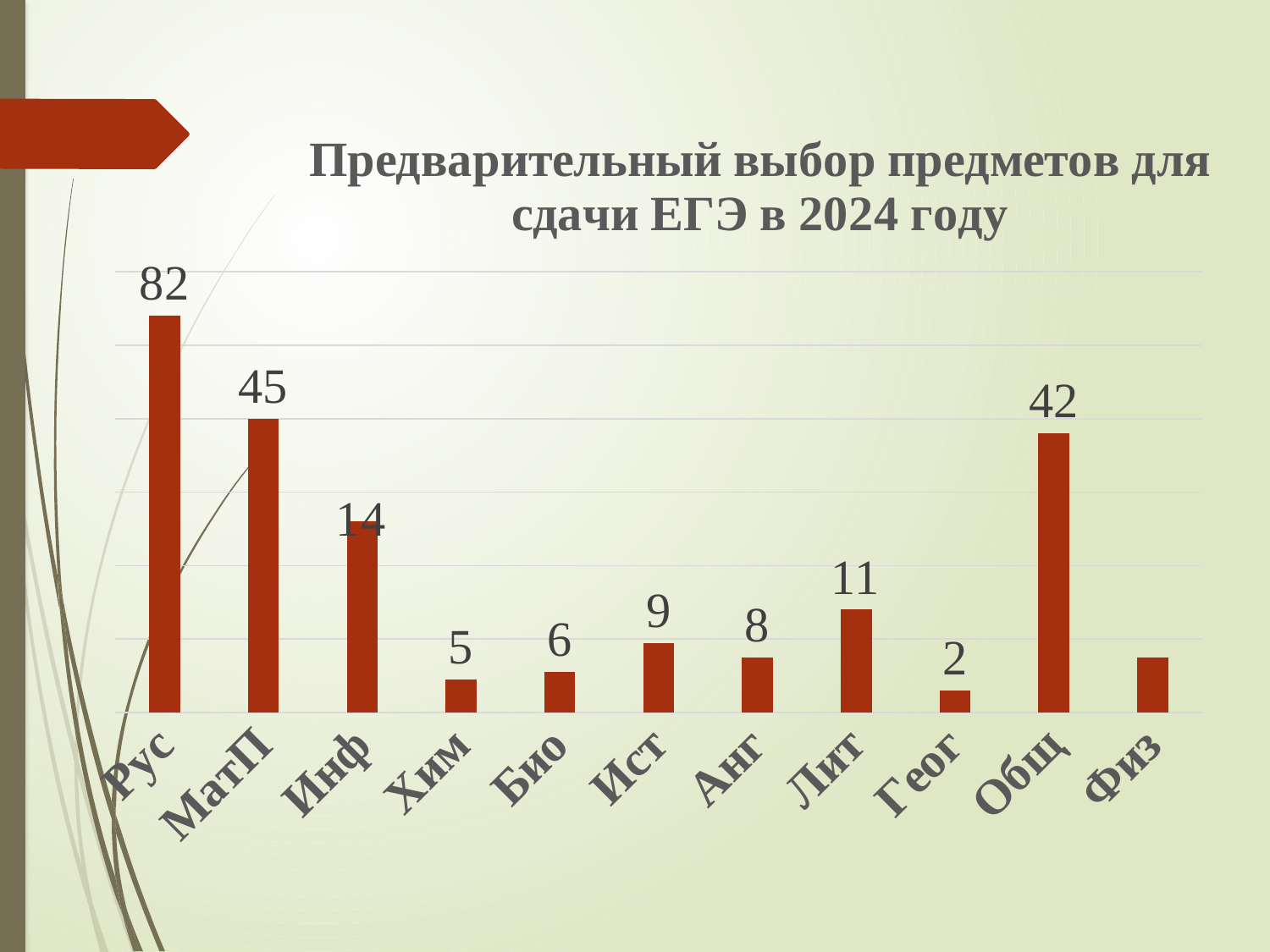
What type of chart is shown on the slide? bar chart What is the difference between the values for Лит and Хим? 6 What is the value for Лит? 11 Which category has the lowest value? Геог What is the value for Общ? 42 What is the value for МатП? 45 Which category has the highest value? Рус What is the title of the chart? Предварительный выбор предметов для сдачи ЕГЭ в 2024 году What is the difference between the values for Рус and МатП? 37 What is the value for Рус? 82 How many categories are shown on the x axis? 11 Which is larger, the value for МатП or the value for Общ? МатП